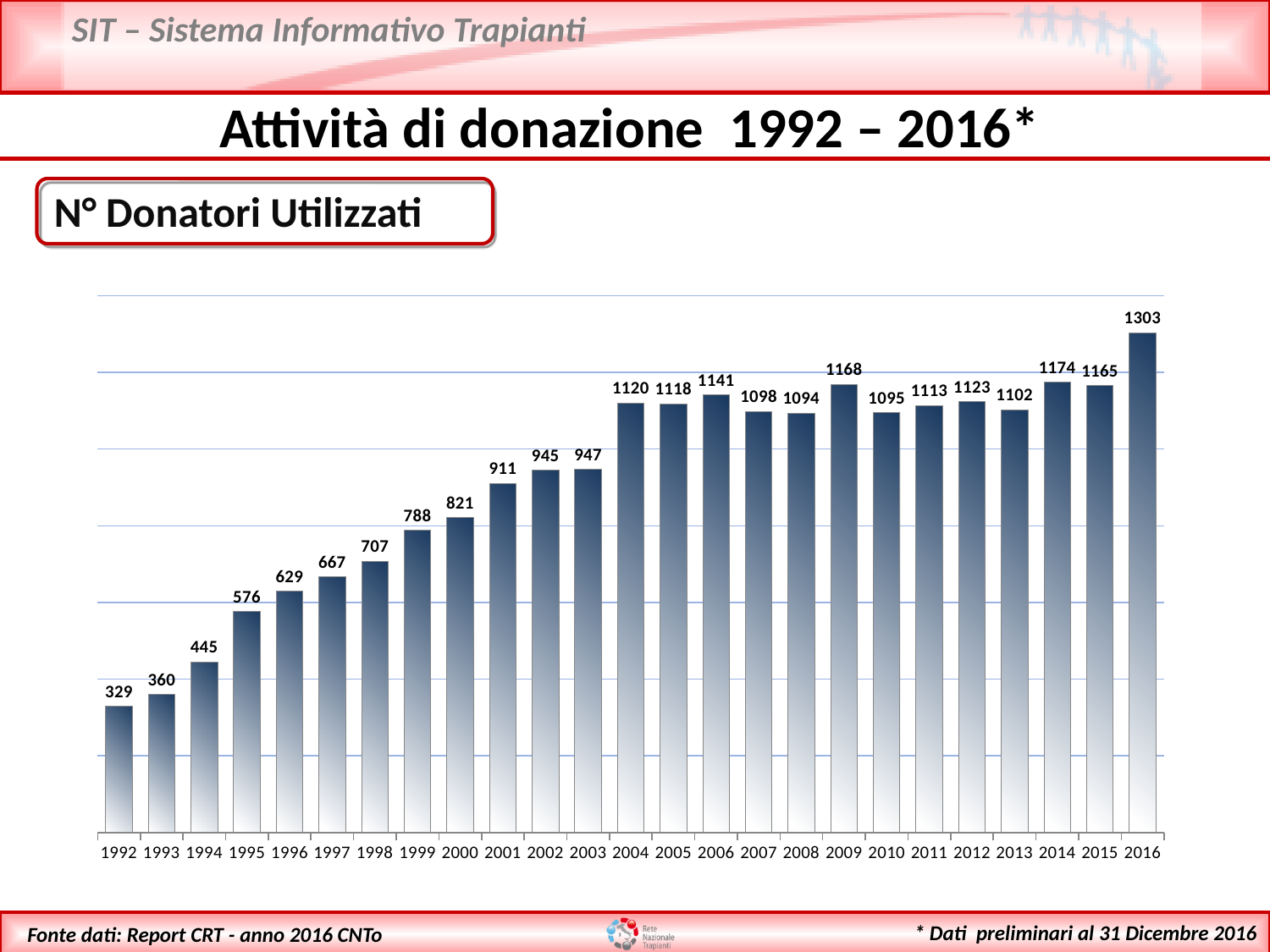
Which year has the lowest value? 1992 What kind of chart is shown on the slide? bar chart Which is larger, the value for 2004 or the value for 2013? 2004 What is the value for 2009? 1168 Do the values generally rise or fall from 1992 to 2016? rise What is the value for 1992? 329 What is the value for 2001? 911 Which year has the highest value? 2016 What is the value for 2016? 1303 What is the difference between the values for 2016 and 2015? 138 What is the difference between the values for 2016 and 1992? 974 How many years are shown on the x axis? 25